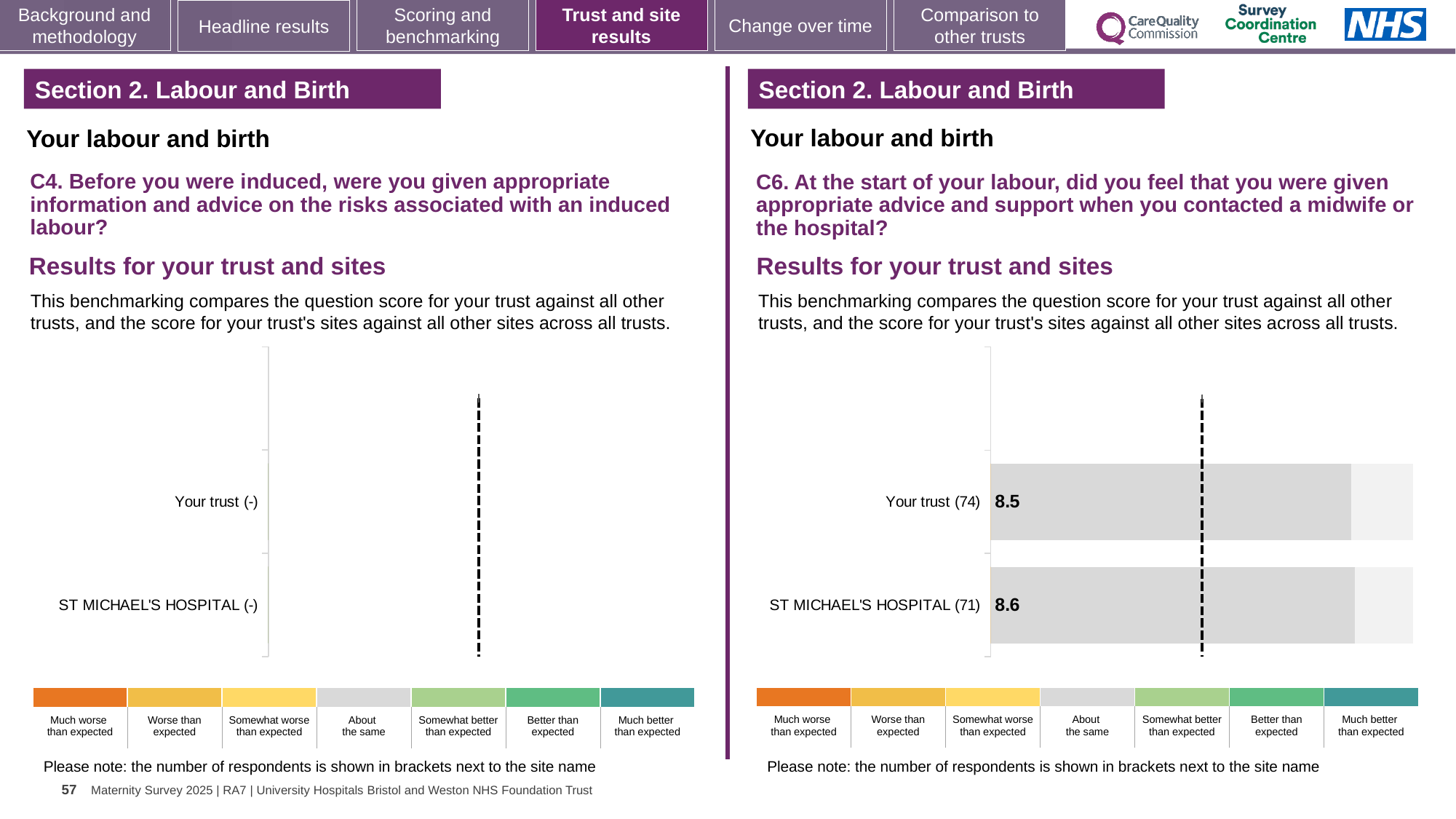
In the C6 chart on the right, how many respondents are shown in brackets for ST MICHAEL'S HOSPITAL? 71 In the C6 chart on the right, how many categories (bars) are plotted? 2 In the C4 chart on the left, how many categories are listed on the vertical axis? 2 In the C6 chart on the right, which category has the lowest score? Your trust In the C6 chart on the right, what is the difference between the ST MICHAEL'S HOSPITAL score and the Your trust score? 0.1 In the C6 chart on the right, which has the higher score, Your trust or ST MICHAEL'S HOSPITAL? ST MICHAEL'S HOSPITAL In the C6 chart on the right, how many respondents are shown in brackets for Your trust? 74 In the C6 chart on the right, what is the score for ST MICHAEL'S HOSPITAL? 8.6 In the C6 chart on the right, what is the score for Your trust? 8.5 What kind of chart is the C6 chart on the right? Bar chart In the C4 chart on the left, what is shown in brackets next to Your trust? -